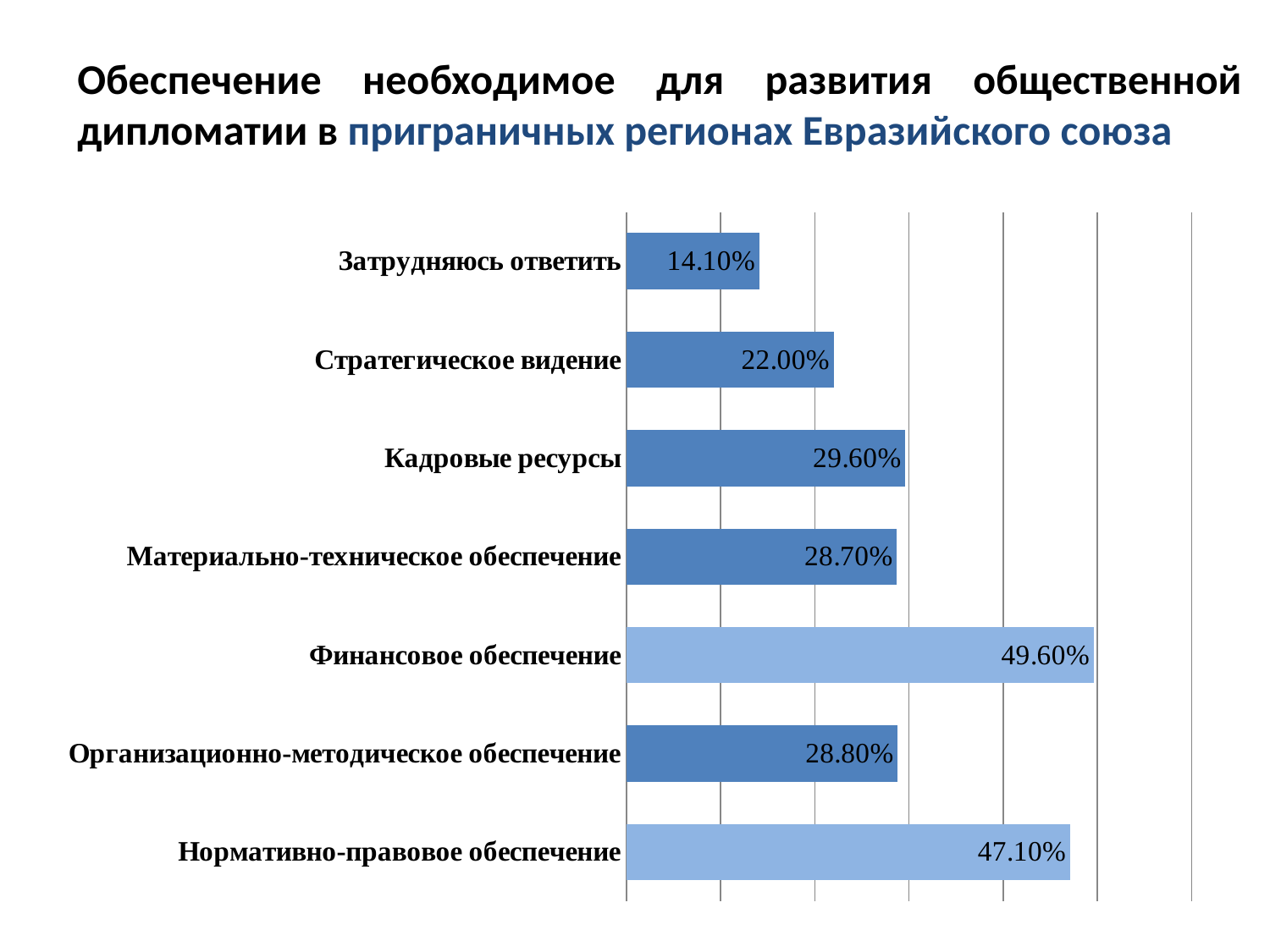
Which two bars are drawn in a lighter shade of blue than the others? Финансовое обеспечение and Нормативно-правовое обеспечение What is the value for Стратегическое видение? 22.00% Which is larger: the value for Кадровые ресурсы or the value for Стратегическое видение? Кадровые ресурсы What is the difference between the values for Финансовое обеспечение and Нормативно-правовое обеспечение? 2.50% What kind of chart is shown on the slide? Bar chart Which category has the lowest value? Затрудняюсь ответить What is the value for Кадровые ресурсы? 29.60% How many categories are shown in the chart? 7 What is the value for Финансовое обеспечение? 49.60% Which category has the highest value? Финансовое обеспечение What is the value for Затрудняюсь ответить? 14.10% What is the value for Нормативно-правовое обеспечение? 47.10%